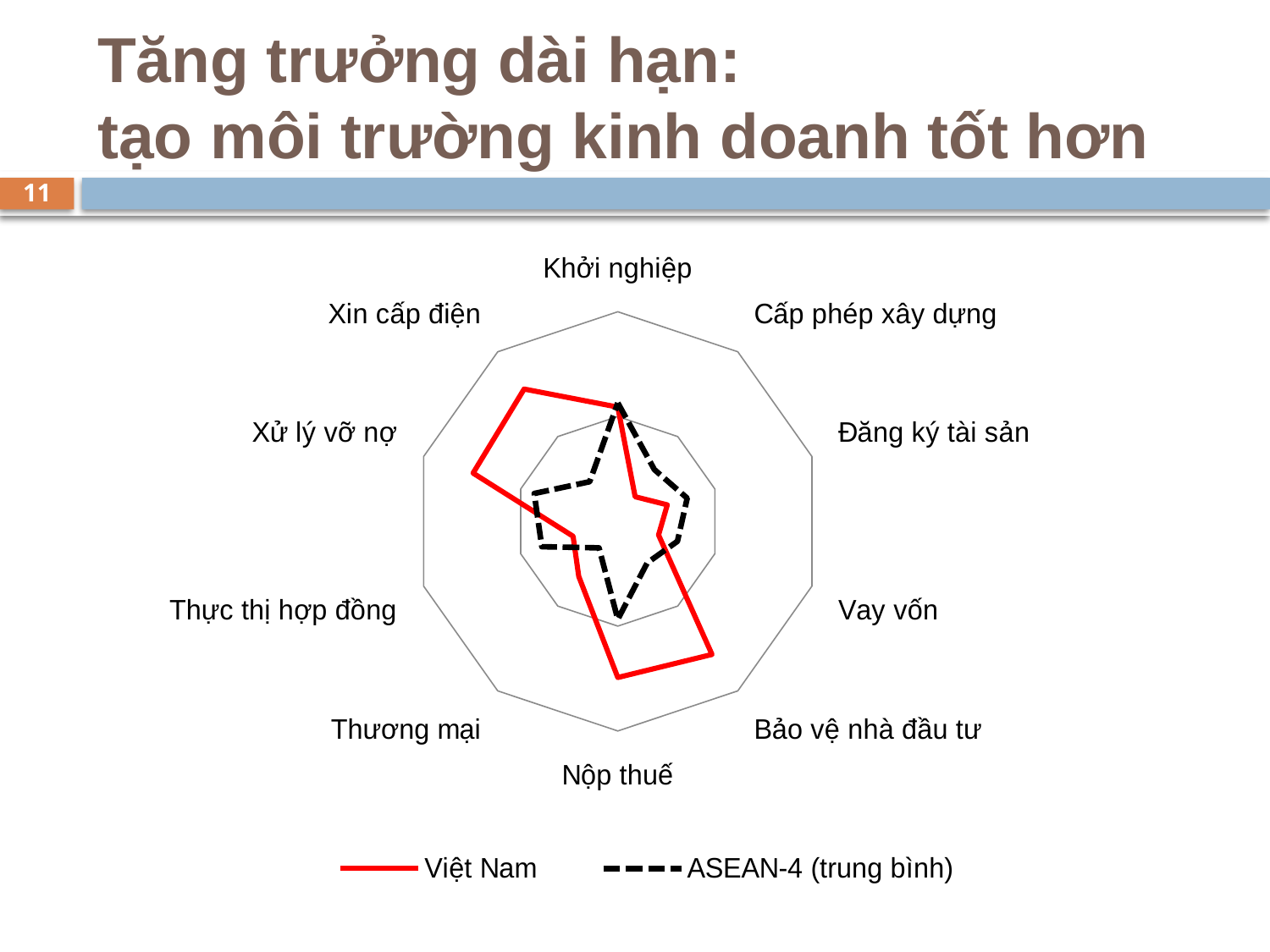
For Nộp thuế, which series has the larger value, Việt Nam or ASEAN-4 (trung bình)? Việt Nam How many series does the legend list? 2 What kind of chart is shown on the slide? Radar chart Which two series are listed in the legend? Việt Nam and ASEAN-4 (trung bình) Which series is drawn with a dashed black line? ASEAN-4 (trung bình) For Xin cấp điện, which series has the larger value, Việt Nam or ASEAN-4 (trung bình)? Việt Nam How many categories (axes) does the radar chart have? 10 For Xử lý vỡ nợ, which series has the larger value, Việt Nam or ASEAN-4 (trung bình)? Việt Nam Which category is at the top of the radar chart? Khởi nghiệp